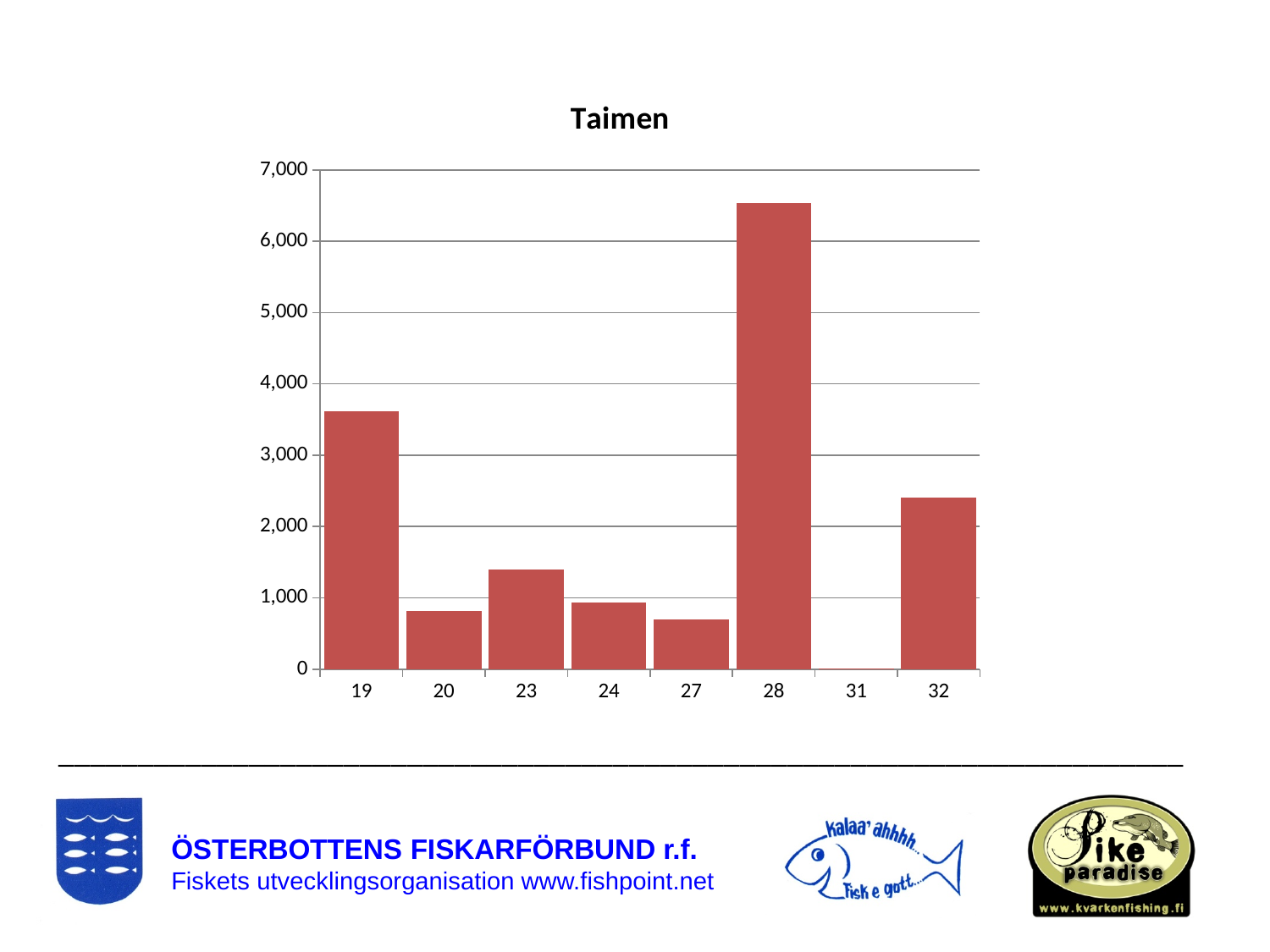
How many categories are shown on the x axis of the chart? 8 Is the value for category 19 greater or less than 3,000? greater Which has the larger value, category 23 or category 27? 23 Which has the larger value, category 19 or category 32? 19 What is the title of the chart? Taimen Is the value for category 28 greater or less than 6,000? greater Which category has the lowest value in the chart? 31 What kind of chart is shown on the slide? bar chart Which category has the highest value in the chart? 28 Is the value for category 32 greater or less than 2,000? greater